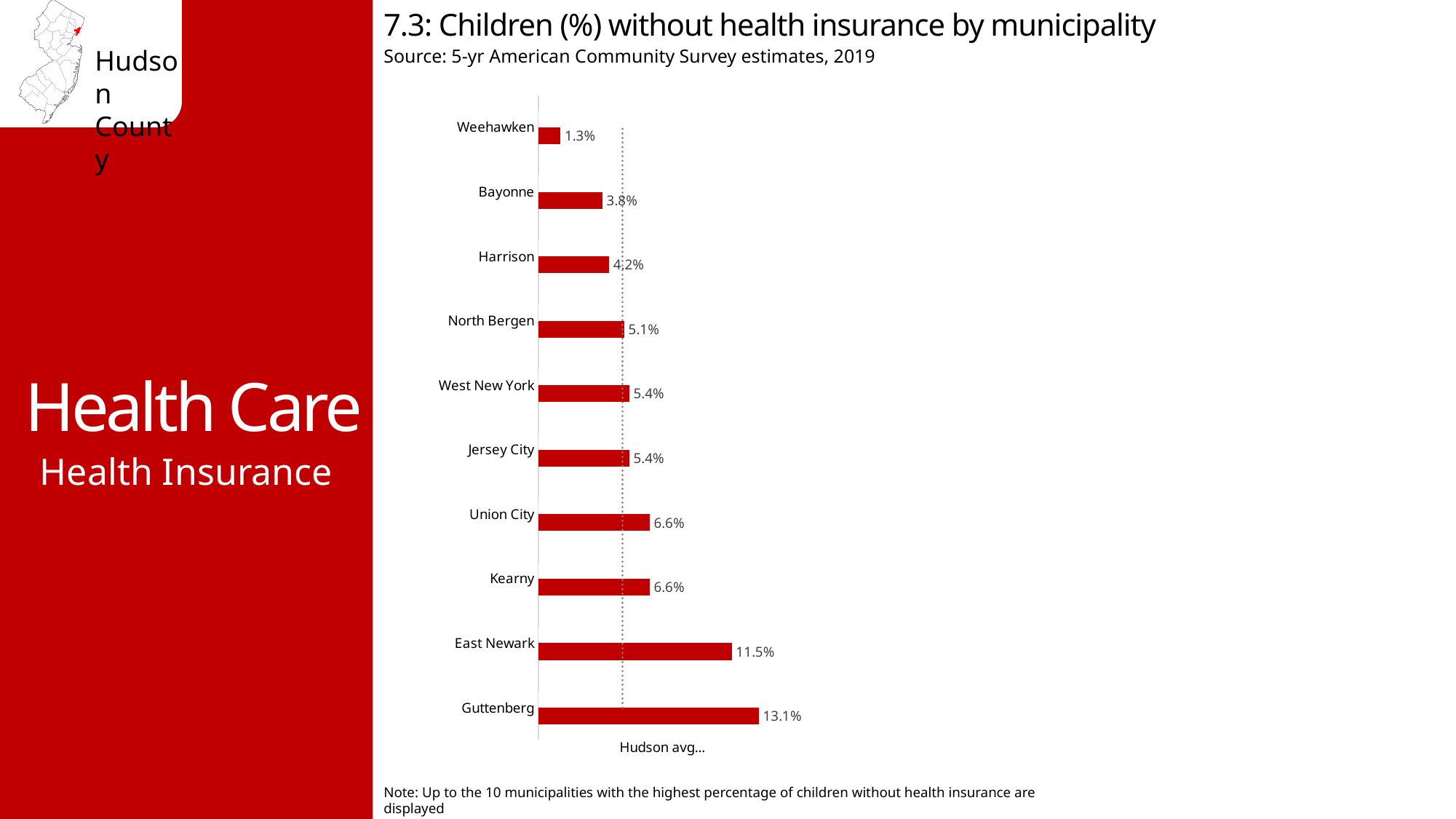
What is the title of the chart? 7.3: Children (%) without health insurance by municipality Which municipality has the highest percentage of children without health insurance? Guttenberg What percentage is shown for Weehawken? 1.3% What is the value shown for East Newark? 11.5% What is the difference between the values for Guttenberg and East Newark? 1.6% What is the difference between the values for Bayonne and Weehawken? 2.5% How many municipalities are shown in the chart? 10 What percentage of children in Guttenberg are without health insurance? 13.1% Which municipality has the lowest percentage of children without health insurance? Weehawken What kind of chart is shown on the slide? Bar chart What is the value for North Bergen? 5.1% Which has a higher value, Union City or Harrison? Union City